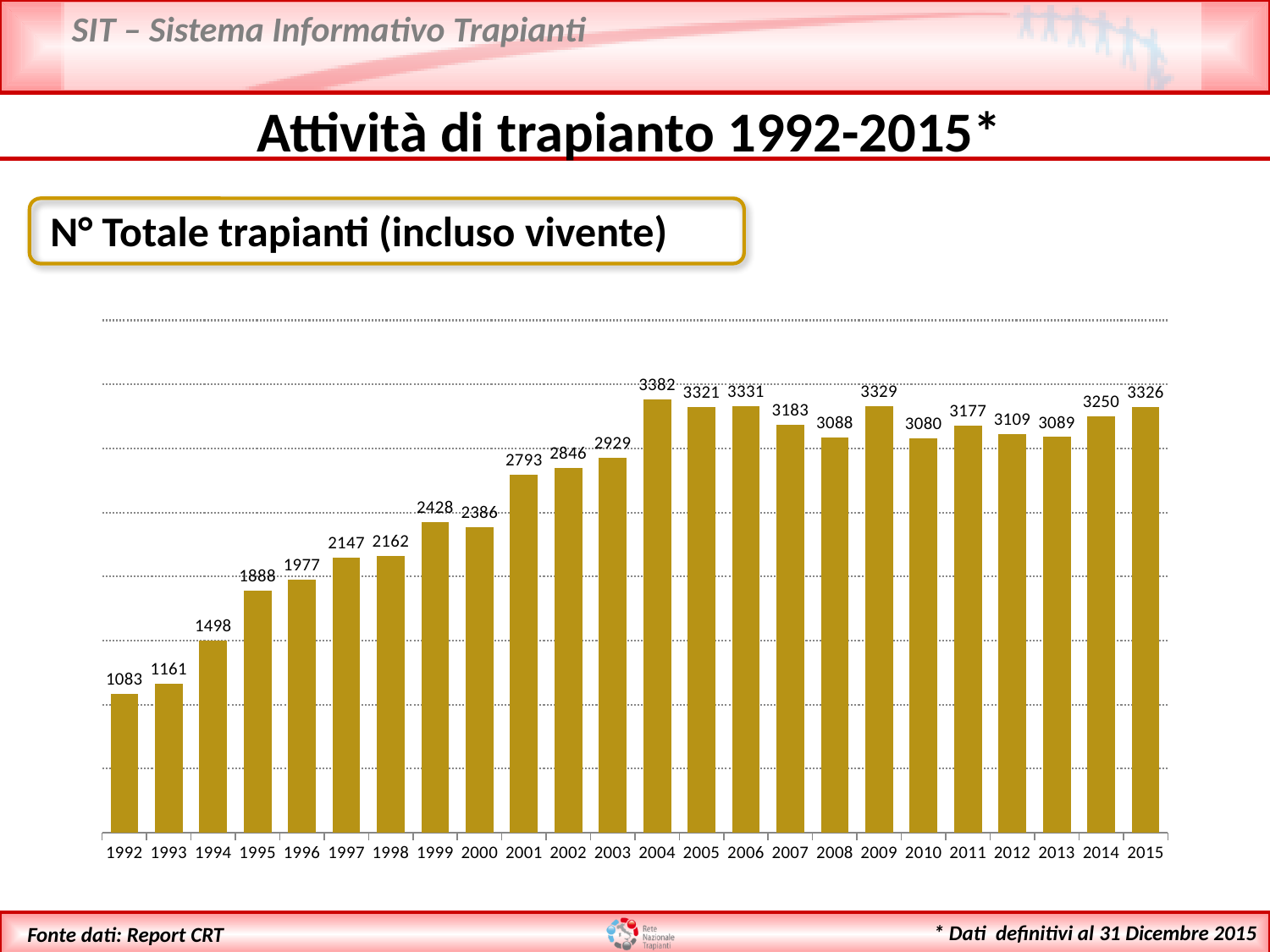
What is the value for 2009? 3329 What is the difference between the values for 2004 and 2005? 61 How many years are shown on the x axis? 24 Which year has the highest value? 2004 What is the difference between the values for 2015 and 1992? 2243 Do the values generally rise or fall from 1992 to 2004? Rise Which year has the lowest value? 1992 What is the value for 1992? 1083 Which is larger, the value for 1999 or the value for 2000? 1999 Which is larger, the value for 2014 or the value for 2013? 2014 What is the value for 2015? 3326 What kind of chart is shown? Bar chart